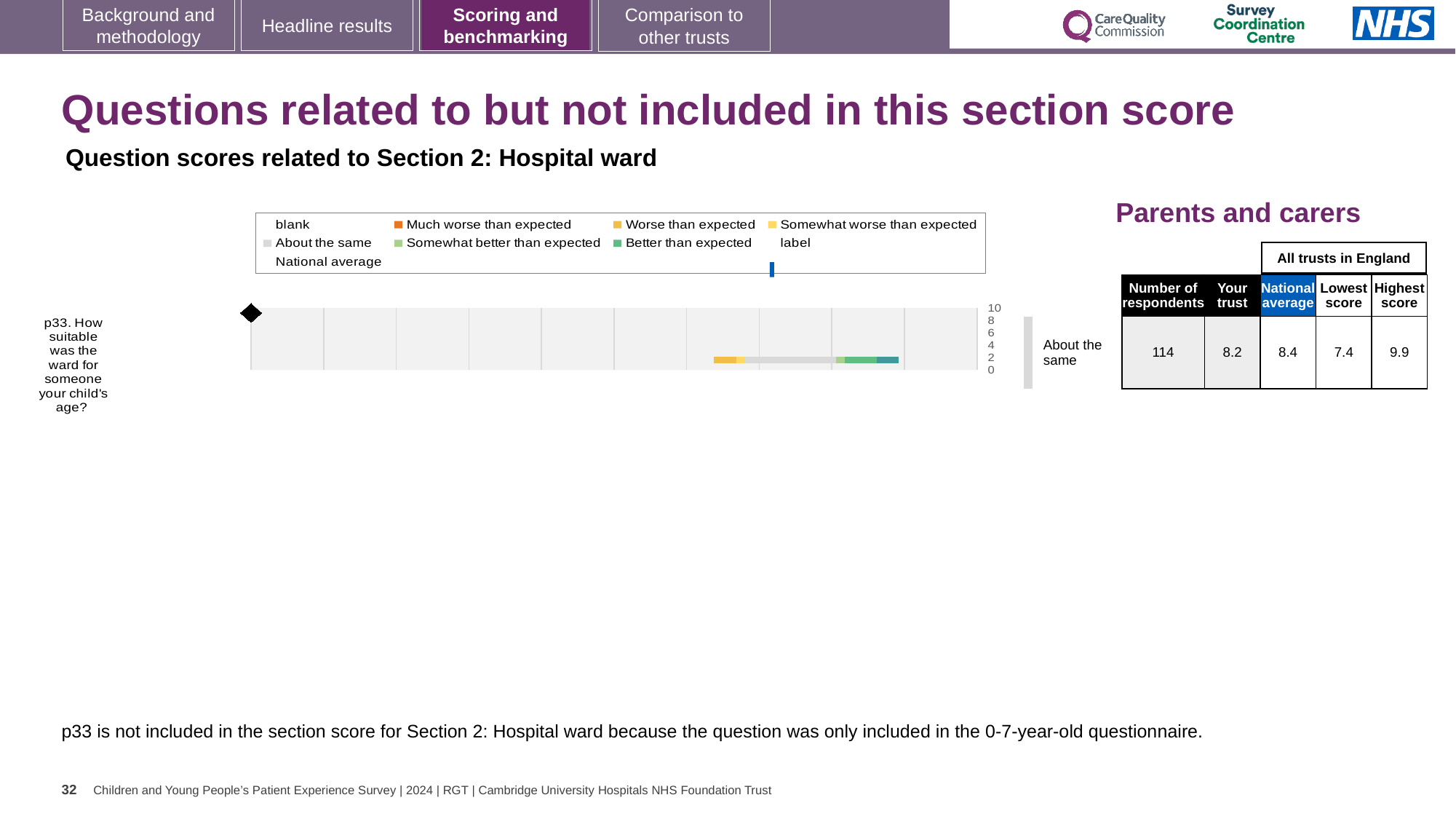
How many entries does the chart legend list? 9 What is the national average score for p33 shown in the table beside the chart? 8.4 What is the lowest score among all trusts in England for p33? 7.4 How many questions (categories) are plotted in the chart? 1 What is the highest value shown on the chart's score axis? 10 What is the 'Your trust' score for p33 in the table beside the chart? 8.2 What is the highest score among all trusts in England for p33? 9.9 How many respondents answered p33 according to the table beside the chart? 114 What kind of chart is shown for question p33? bar chart For p33, which is larger: the 'Your trust' score or the national average? National average What is the difference between the highest and lowest trust scores for p33? 2.5 Which benchmark category is the p33 result labelled as next to the chart? About the same